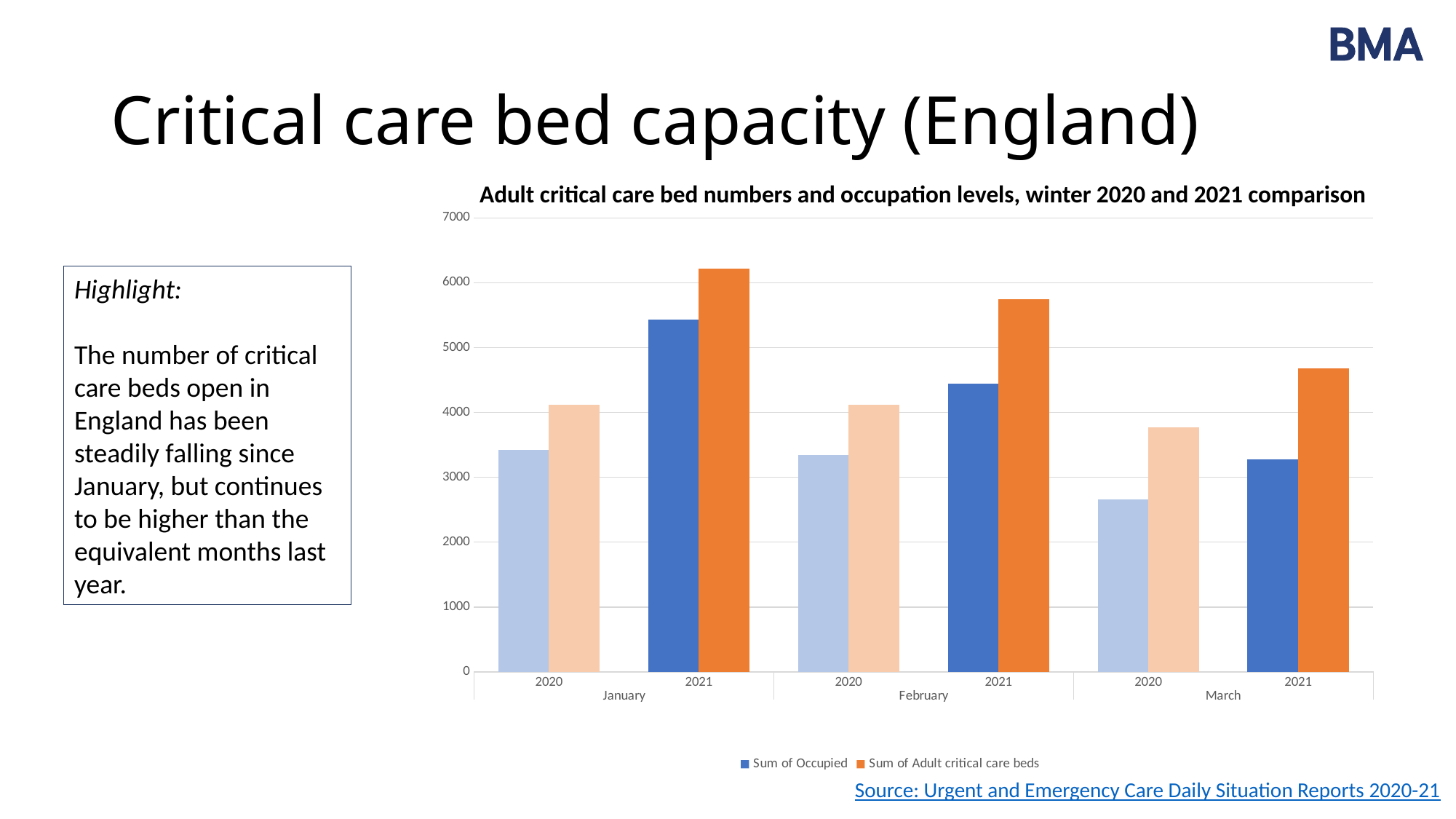
Which month and year has the lowest Sum of Occupied? March 2020 Which month and year has the highest Sum of Adult critical care beds? January 2021 What is the title of the chart? Adult critical care bed numbers and occupation levels, winter 2020 and 2021 comparison What kind of chart is shown on the slide? Bar chart Does the Sum of Adult critical care beds for 2021 rise or fall from January to March? Fall Is the Sum of Adult critical care beds for January 2021 greater or less than 6000? greater Is the Sum of Occupied for February 2021 greater or less than 4000? greater Is the Sum of Occupied for March 2020 greater or less than 3000? less Which is larger, the Sum of Occupied for January 2021 or for February 2021? January 2021 How many series does the legend list? 2 Which series is shown in orange? Sum of Adult critical care beds How many months are shown along the x axis? 3